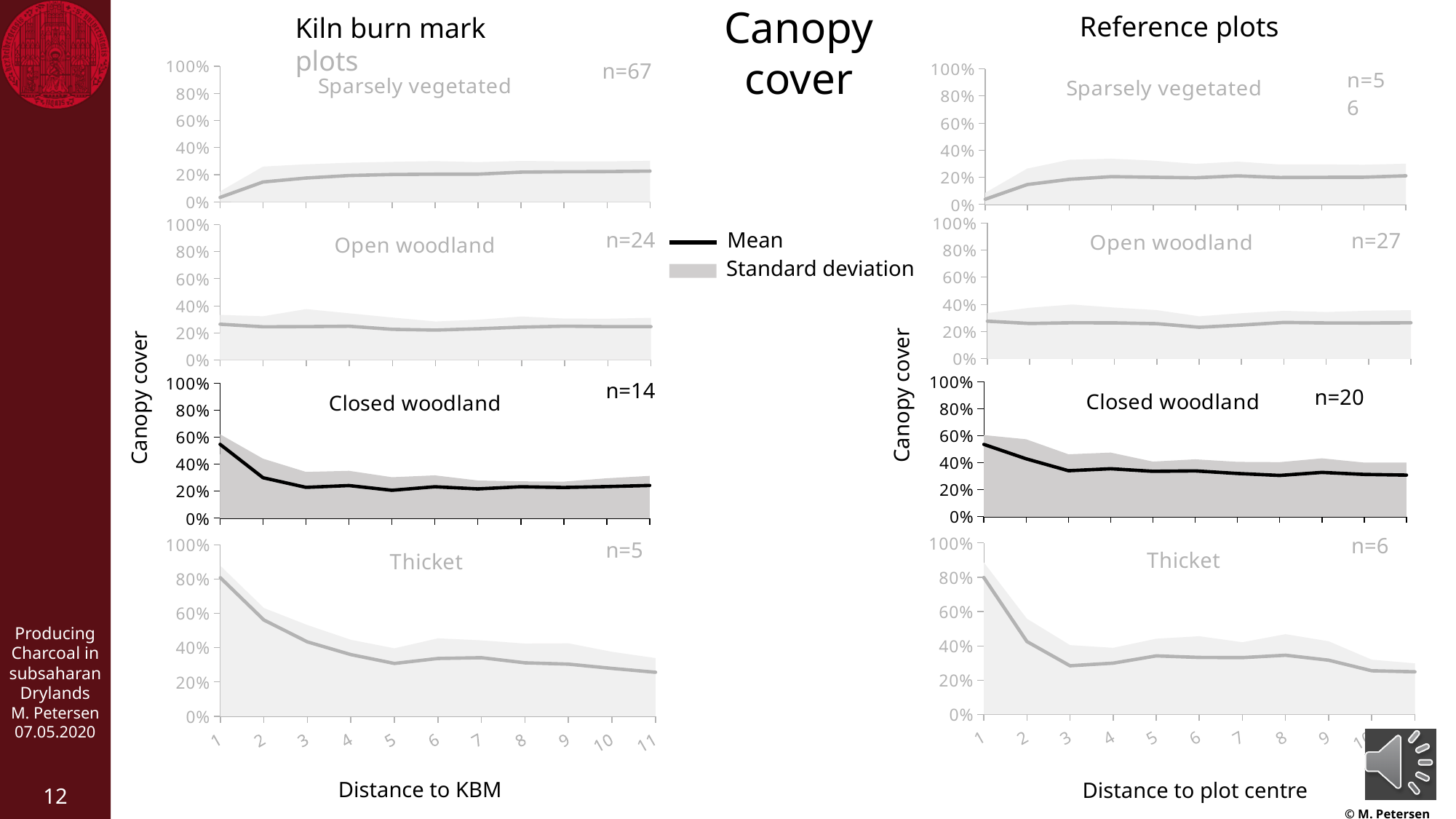
In the Sparsely vegetated chart under Kiln burn mark plots, does the mean canopy cover rise or fall from distance 1 to distance 11? rise In the Closed woodland chart under Reference plots, is the mean canopy cover at distance 1 greater or less than 40%? greater How many distance points are shown on the x axis of the Thicket chart under Kiln burn mark plots? 11 What is the x-axis label for the charts under Kiln burn mark plots? Distance to KBM What is the n value shown on the Closed woodland chart under Reference plots? n=20 In the Thicket chart under Reference plots, is the mean canopy cover at distance 3 greater or less than 40%? less What kind of chart is the Closed woodland chart under Kiln burn mark plots? area and line chart How many entries does the legend in the middle of the slide list? 2 In the Closed woodland chart under Kiln burn mark plots, which distance has the highest mean canopy cover? 1 In the Thicket chart under Kiln burn mark plots, does the mean canopy cover rise or fall as distance to KBM increases? fall In the Thicket chart under Kiln burn mark plots, is the mean canopy cover at distance 1 greater or less than 60%? greater